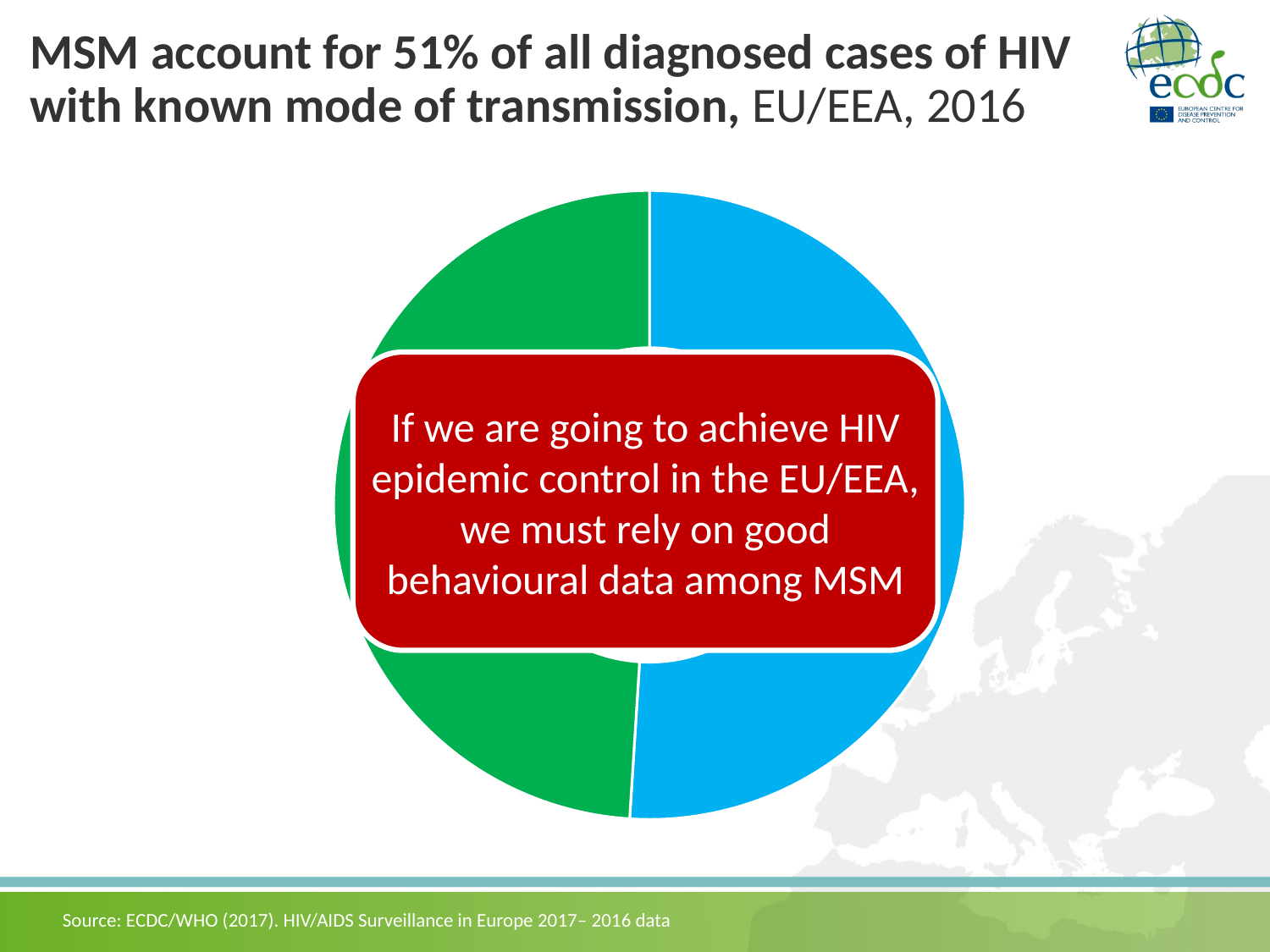
How many slices does the pie chart have? 2 What year and region does the slide title say the data refer to? EU/EEA, 2016 What kind of chart is shown on the slide? Pie chart Which two colours are used for the slices of the pie chart? Blue and green According to the slide title, what share of all diagnosed HIV cases with known mode of transmission do MSM account for? 51%